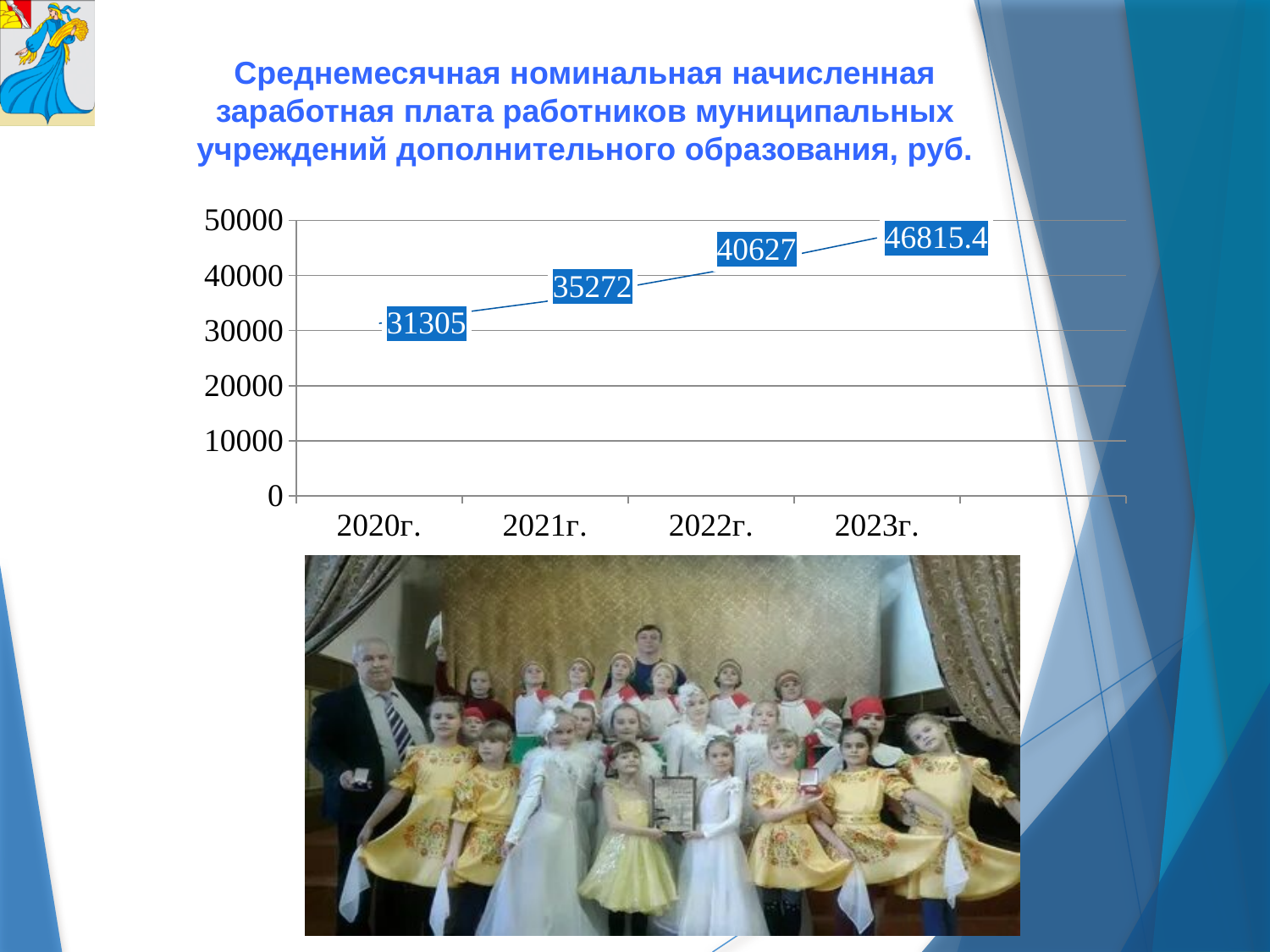
What was the average monthly salary in 2023г.? 46815.4 Which is larger, the salary in 2021г. or in 2022г.? 2022г. How many years are shown on the chart? 4 By how much did the average monthly salary increase from 2022г. to 2023г.? 6188.4 Which year has the lowest average monthly salary? 2020г. Do the values rise or fall from 2020г. to 2023г.? rise What was the average monthly salary in 2022г.? 40627 What was the average monthly salary in 2020г.? 31305 Is the value for 2020г. greater or less than 30000? greater What was the average monthly salary in 2021г.? 35272 Which year has the highest average monthly salary? 2023г. By how much did the average monthly salary increase from 2020г. to 2021г.? 3967